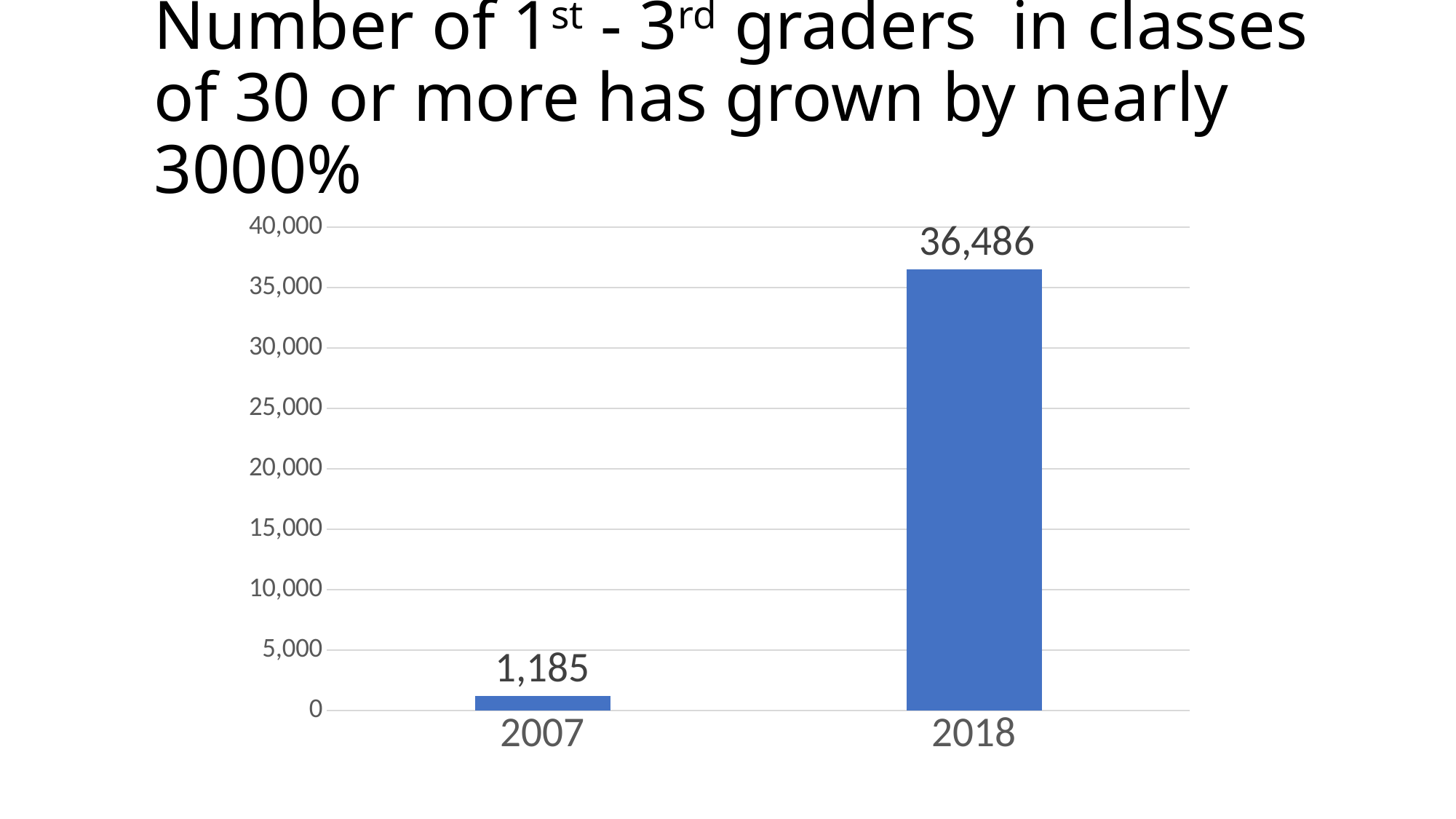
Do the values rise or fall from 2007 to 2018? rise What is the value for 2007? 1,185 What is the value for 2018? 36,486 What is the difference between the values for 2018 and 2007? 35,301 What kind of chart is shown on the slide? bar chart Is the value for 2018 greater or less than 35,000? greater Is the value for 2007 greater or less than 5,000? less Which is larger, the value for 2007 or the value for 2018? 2018 What is the highest value shown on the y axis? 40,000 Which year has the highest value? 2018 How many categories are shown on the x axis? 2 Which year has the lowest value? 2007